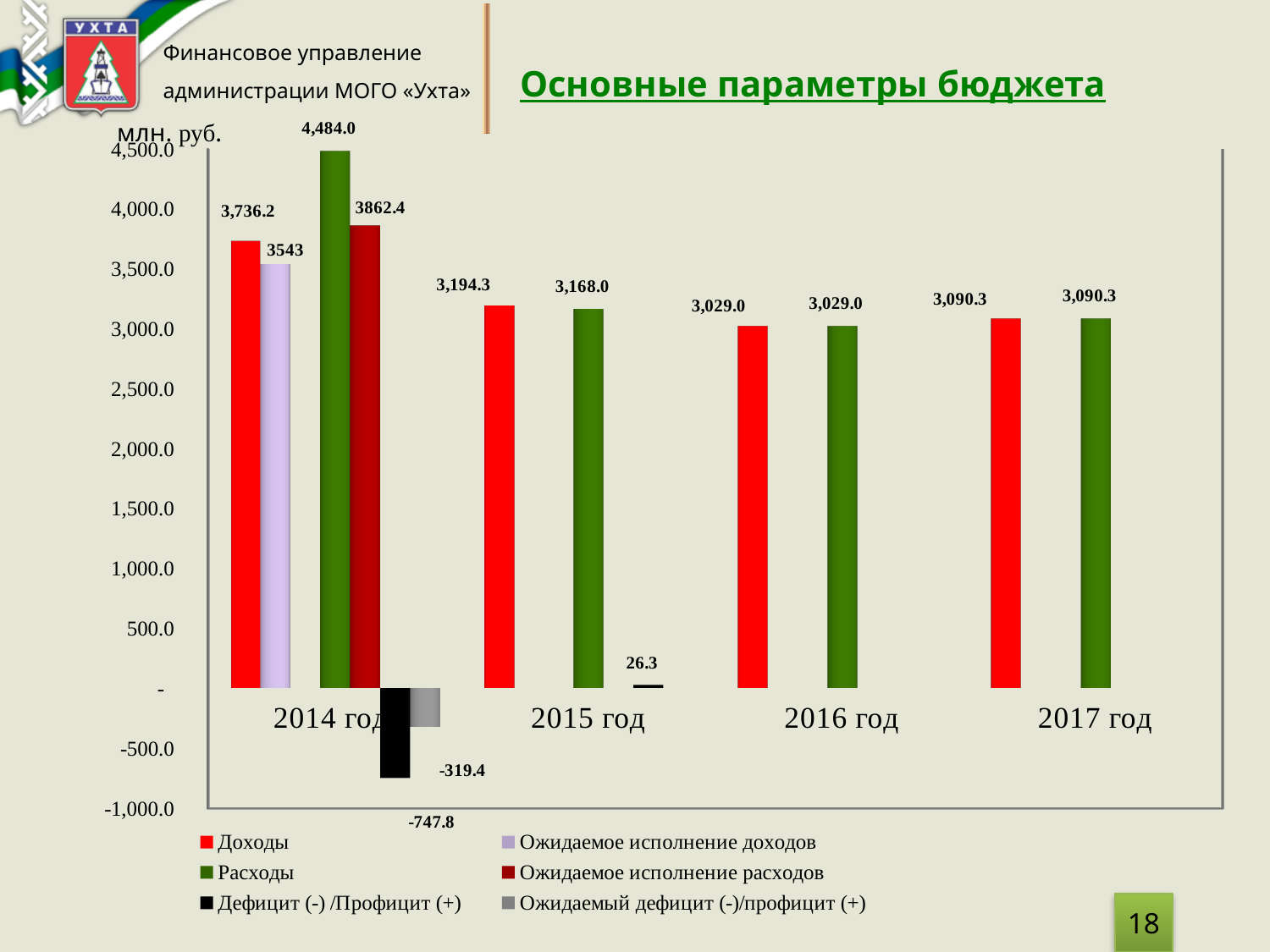
What is the value of Ожидаемое исполнение расходов for 2014 год? 3862.4 How many series does the legend list? 6 What is the value of Доходы for 2015 год? 3,194.3 In which year is Доходы lowest? 2016 год What is the value of Дефицит (-) /Профицит (+) for 2014 год? -747.8 In which year is Расходы highest? 2014 год What is the value of Расходы for 2014 год? 4,484.0 Which is larger for 2014 год: Доходы or Ожидаемое исполнение доходов? Доходы What is the difference between Расходы and Доходы for 2014 год? 747.8 What kind of chart is shown on the slide? Bar chart What is the value of Дефицит (-) /Профицит (+) for 2015 год? 26.3 What is the value of Доходы for 2014 год? 3,736.2